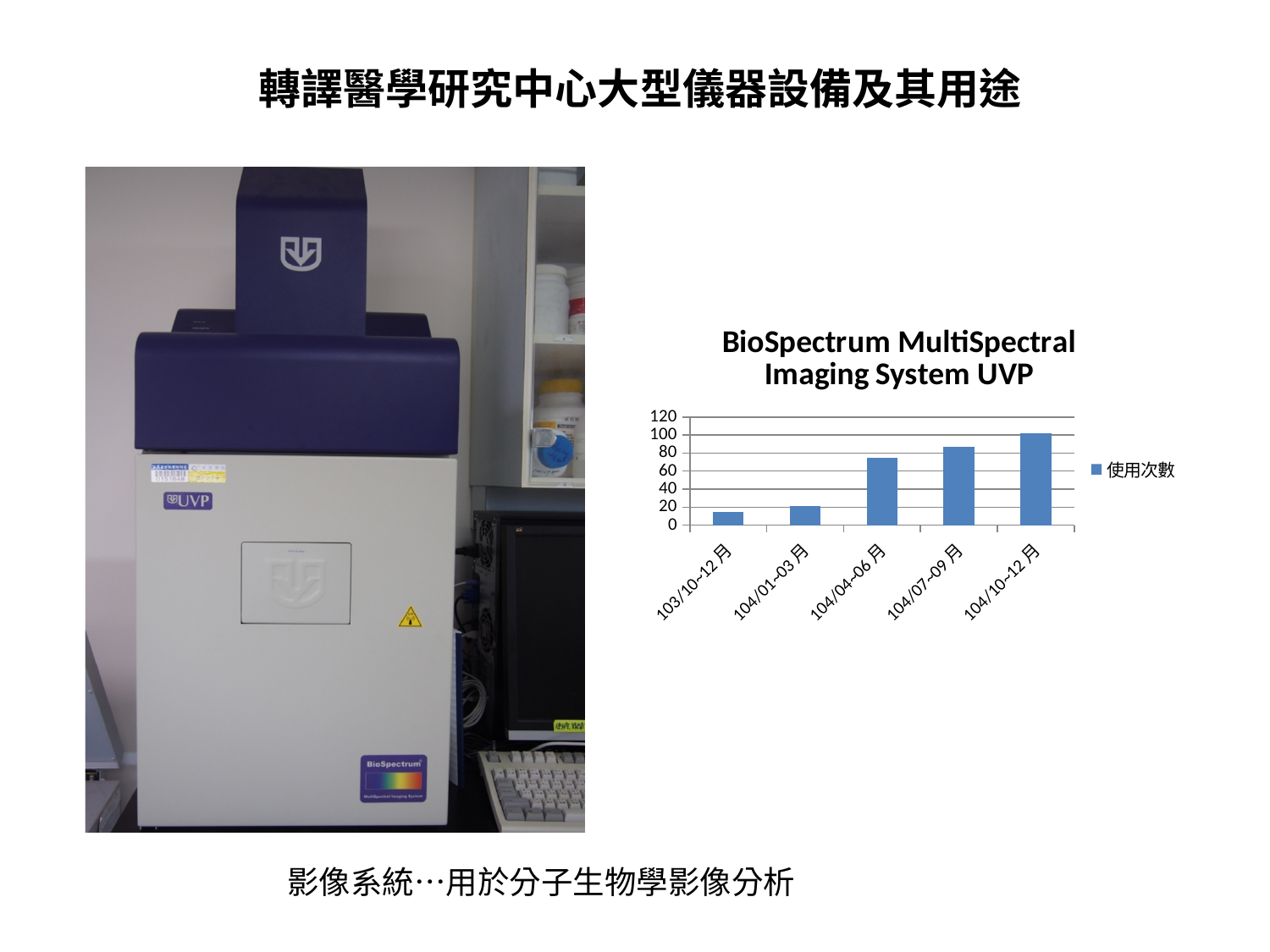
How many categories are shown on the x axis? 5 What kind of chart is shown on the slide? bar chart Which period has the highest value? 104/10~12月 Is the value for 104/07~09月 greater or less than 80? greater How many series does the legend list? 1 Is the value for 104/04~06月 greater or less than 60? greater What is the title of the chart? BioSpectrum MultiSpectral Imaging System UVP Is the value for 103/10~12月 greater or less than 20? less Do the values rise or fall from 103/10~12月 to 104/10~12月? rise What is the name of the series shown in the legend? 使用次數 Which period has the lowest value? 103/10~12月 Which is larger, the value for 104/01~03月 or the value for 104/04~06月? 104/04~06月